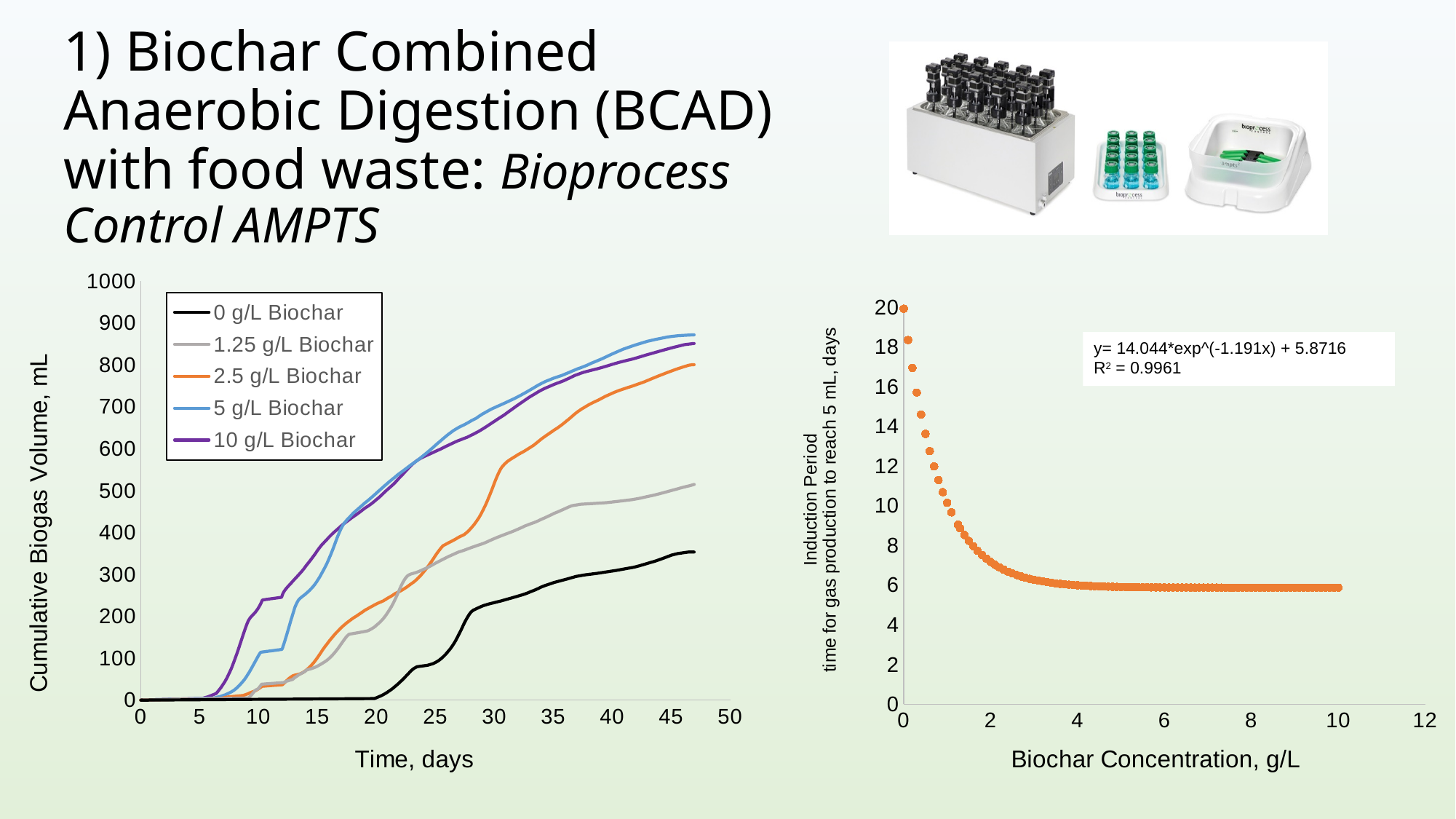
In the right chart (Induction Period), do the values rise or fall as Biochar Concentration increases? fall In the left chart (Cumulative Biogas Volume), does the 10 g/L Biochar series rise or fall as time increases? rise What kind of chart is the right chart showing Induction Period versus Biochar Concentration? scatter chart In the left chart (Cumulative Biogas Volume), is the value for 5 g/L Biochar at day 45 greater or less than 800? greater In the left chart (Cumulative Biogas Volume), is the value for 0 g/L Biochar at day 45 greater or less than 400? less How many series does the legend of the left chart (Cumulative Biogas Volume) list? 5 In the left chart (Cumulative Biogas Volume), which series has the lowest value at day 45? 0 g/L Biochar What R² value is shown on the right chart (Induction Period)? 0.9961 In the right chart (Induction Period), is the value at a Biochar Concentration of 10 g/L greater or less than 8? less What kind of chart is the left chart showing Cumulative Biogas Volume over time? line chart In the left chart (Cumulative Biogas Volume), is the value for 2.5 g/L Biochar at day 45 larger than the value for 1.25 g/L Biochar at day 45? yes